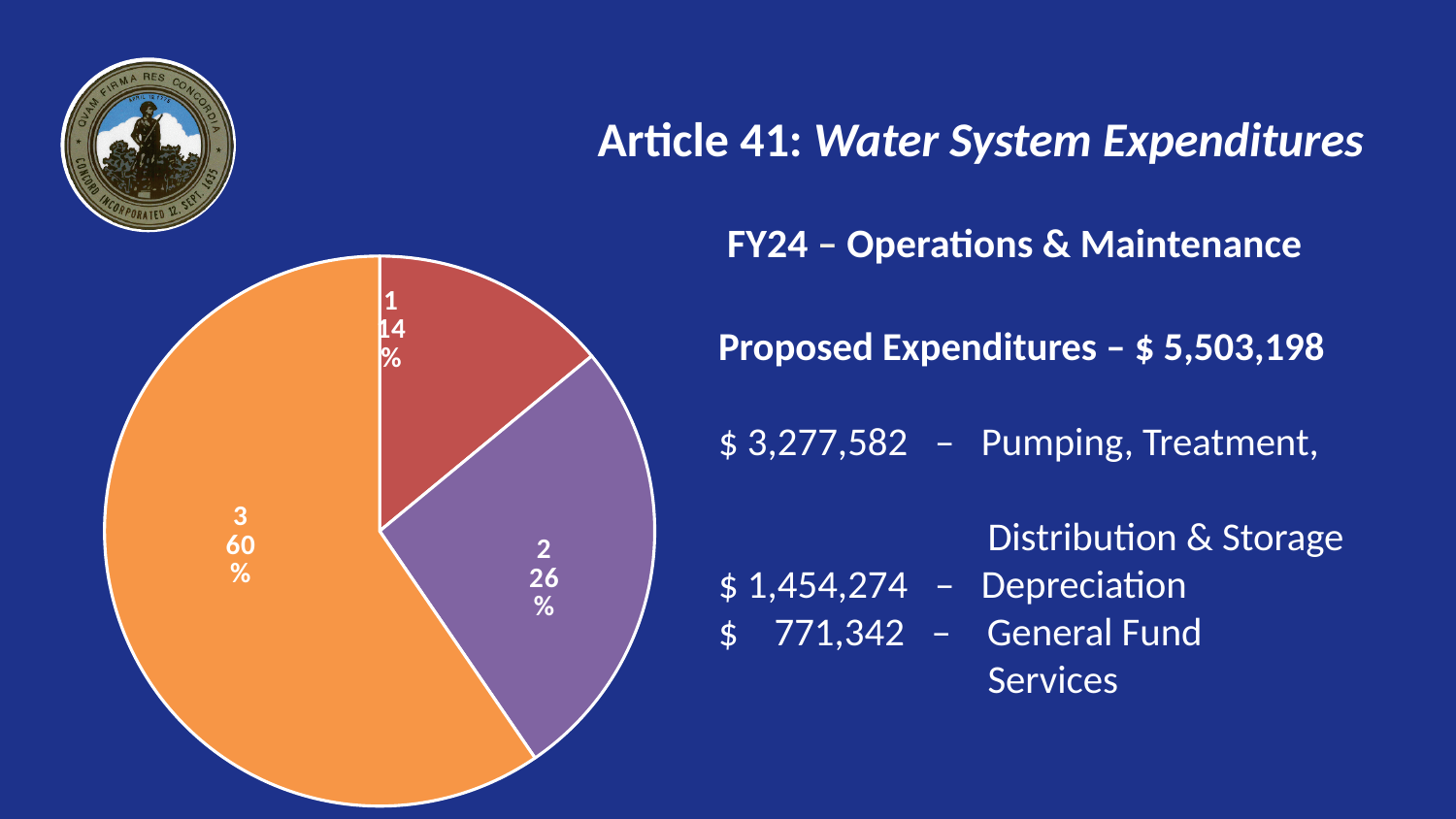
What percentage does slice 1 of the pie chart represent? 14% Which is larger in the pie chart, slice 2 or slice 1? 2 What is the difference in percentage points between slice 2 and slice 1 of the pie chart? 12 Which slice of the pie chart is the largest? 3 Which slice of the pie chart is the smallest? 1 What percentage does slice 3 of the pie chart represent? 60% What colour is slice 2 of the pie chart? purple What is the difference in percentage points between slice 3 and slice 2 of the pie chart? 34 What percentage does slice 2 of the pie chart represent? 26% What kind of chart is shown on the slide? pie chart What colour is the largest slice of the pie chart? orange How many slices does the pie chart have? 3